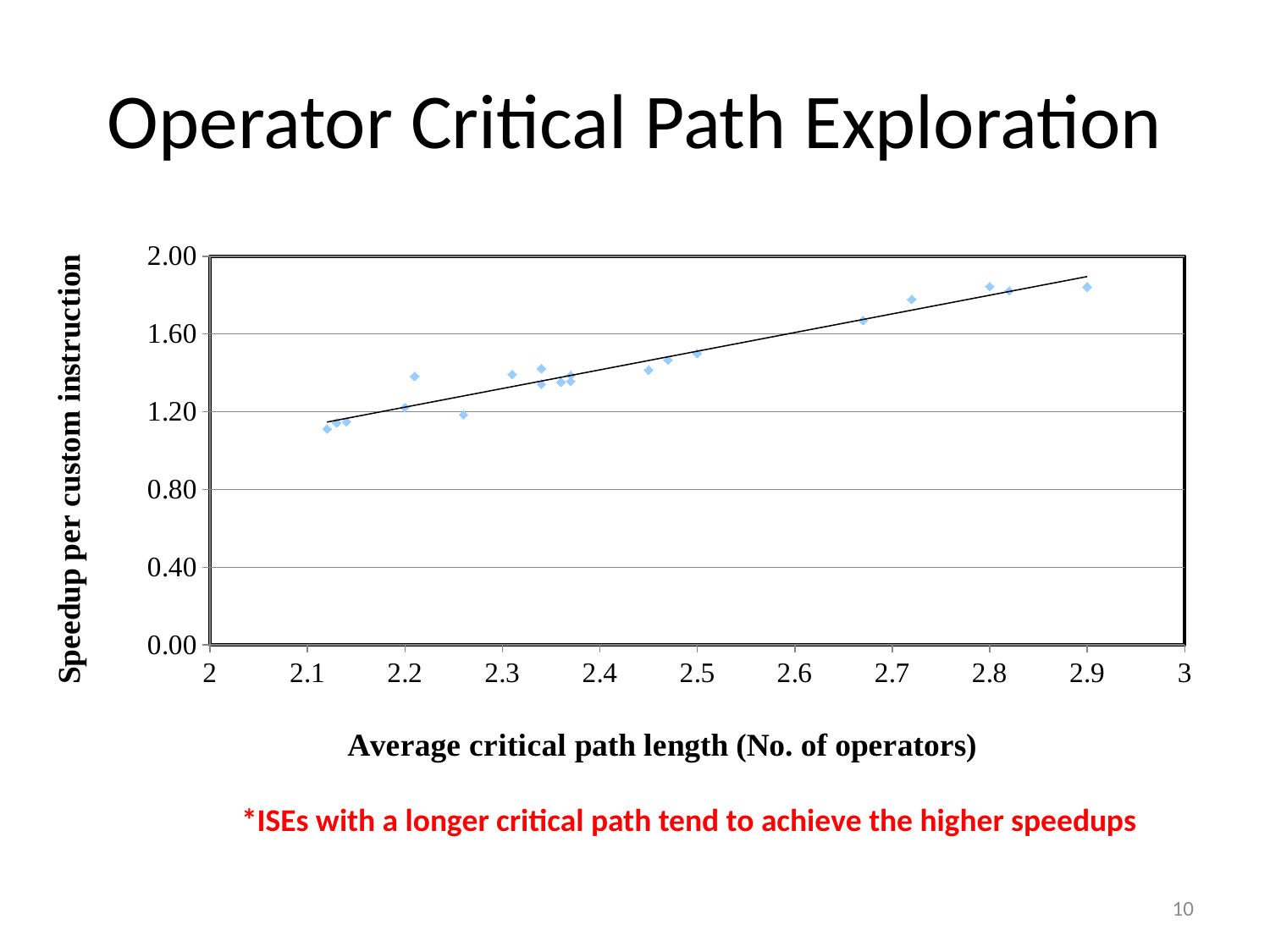
Do the speedup values generally rise or fall as the average critical path length increases? rise Is the speedup value for the point at an average critical path length of about 2.12 greater or less than 1.20? less Is the speedup value for the point at an average critical path length of about 2.45 greater or less than 1.60? less Is the speedup value for the point at an average critical path length of about 2.67 greater or less than 1.60? greater What is the title of the vertical axis of the chart? Speedup per custom instruction What kind of chart is shown on the slide? scatter chart What is the title of the horizontal axis of the chart? Average critical path length (No. of operators) Which point has the larger speedup: the one at an average critical path length of 2.5 or the one at about 2.72? 2.72 Which point has the larger speedup: the one at an average critical path length of 2.9 or the one at about 2.12? 2.9